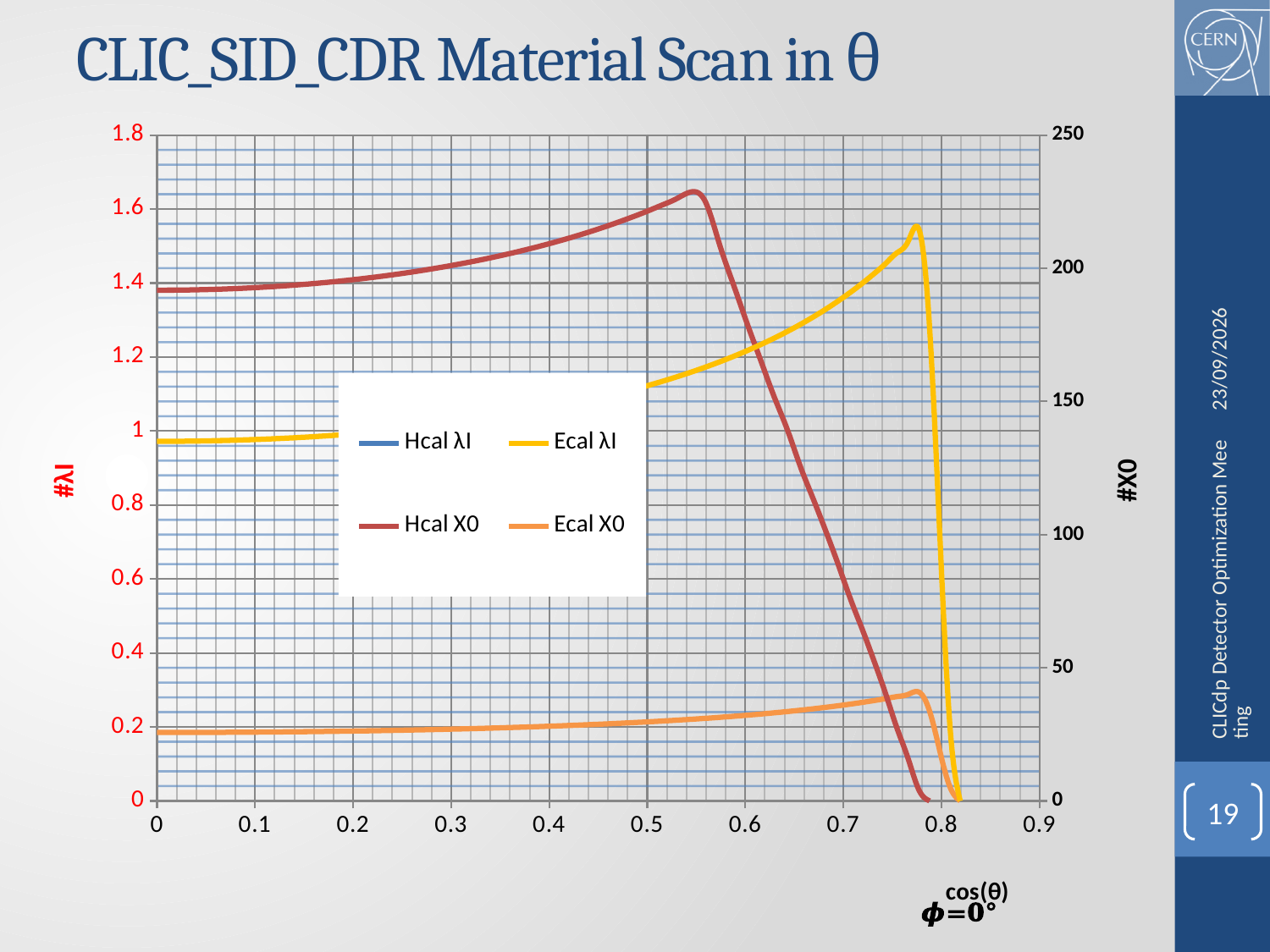
Which series reaches the highest point on the chart? Hcal X0 Between cos(θ) = 0 and cos(θ) = 0.5, does the Hcal X0 line rise or fall? rise What is the label of the left vertical axis? #λI Does the Hcal X0 line reach its peak at a cos(θ) value greater or less than 0.5? greater What kind of chart is shown on the slide? line chart Does the Ecal λI line reach its peak at a cos(θ) value greater or less than 0.7? greater What is the highest tick value shown on the left vertical axis (#λI)? 1.8 At cos(θ) = 0.3, which line is plotted higher on the chart, Hcal X0 or Ecal X0? Hcal X0 How many series does the chart legend list? 4 What is the highest tick value shown on the right vertical axis (#X0)? 250 Between cos(θ) = 0.6 and cos(θ) = 0.75, does the Hcal X0 line rise or fall? fall What is the title of the chart on the slide? CLIC_SID_CDR Material Scan in θ